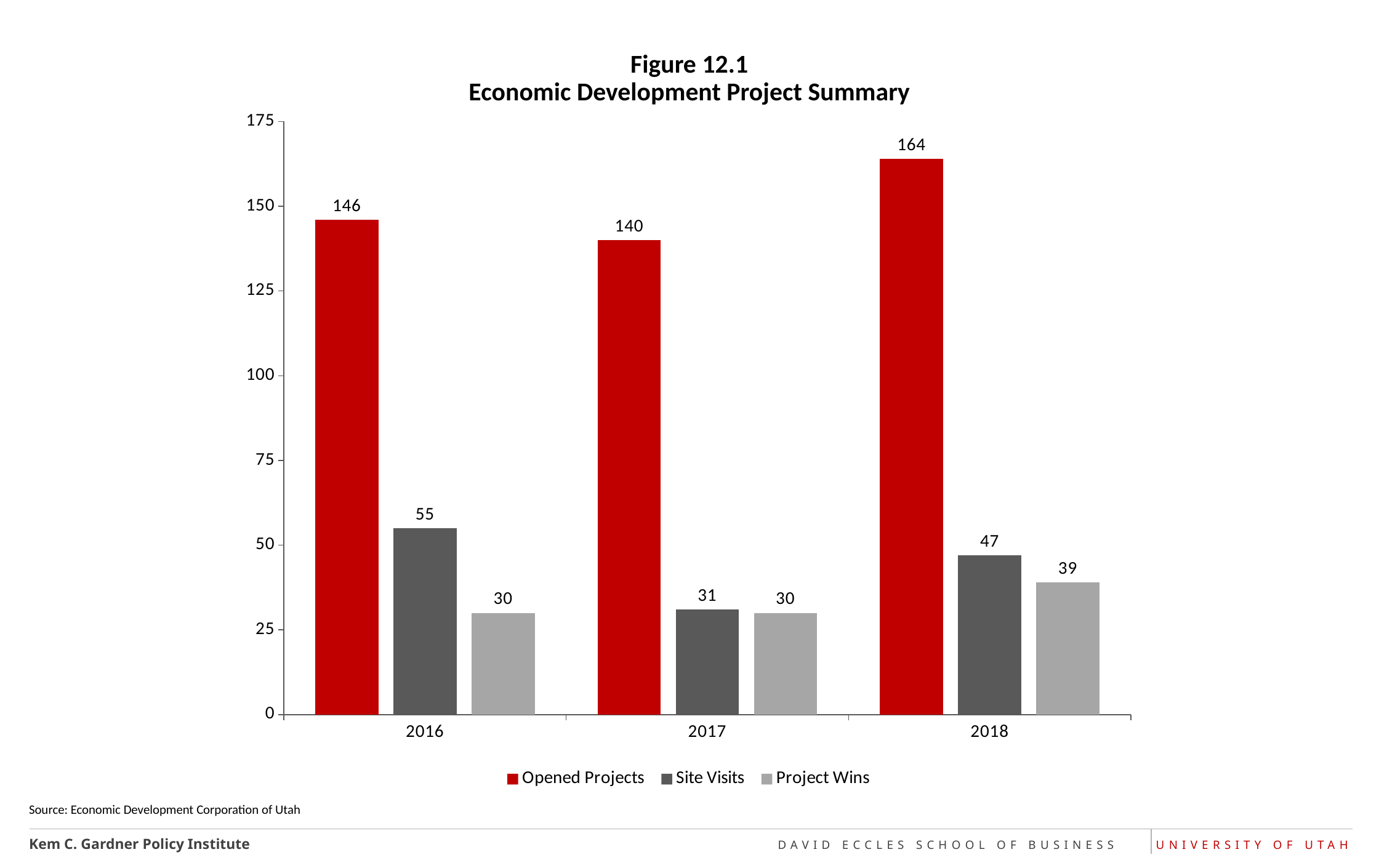
What is the value for Project Wins in 2017? 30 Is the value for Opened Projects in 2016 greater or less than 125? greater In which year were Site Visits lowest? 2017 What is the title of the chart? Figure 12.1 Economic Development Project Summary How many series does the legend list? 3 How many years are shown on the x axis? 3 In which year were Opened Projects highest? 2018 What is the value for Opened Projects in 2018? 164 What kind of chart is shown on the slide? bar chart Which is larger: Site Visits in 2018 or Project Wins in 2018? Site Visits in 2018 What is the value for Site Visits in 2016? 55 What is the difference between Opened Projects in 2018 and in 2017? 24